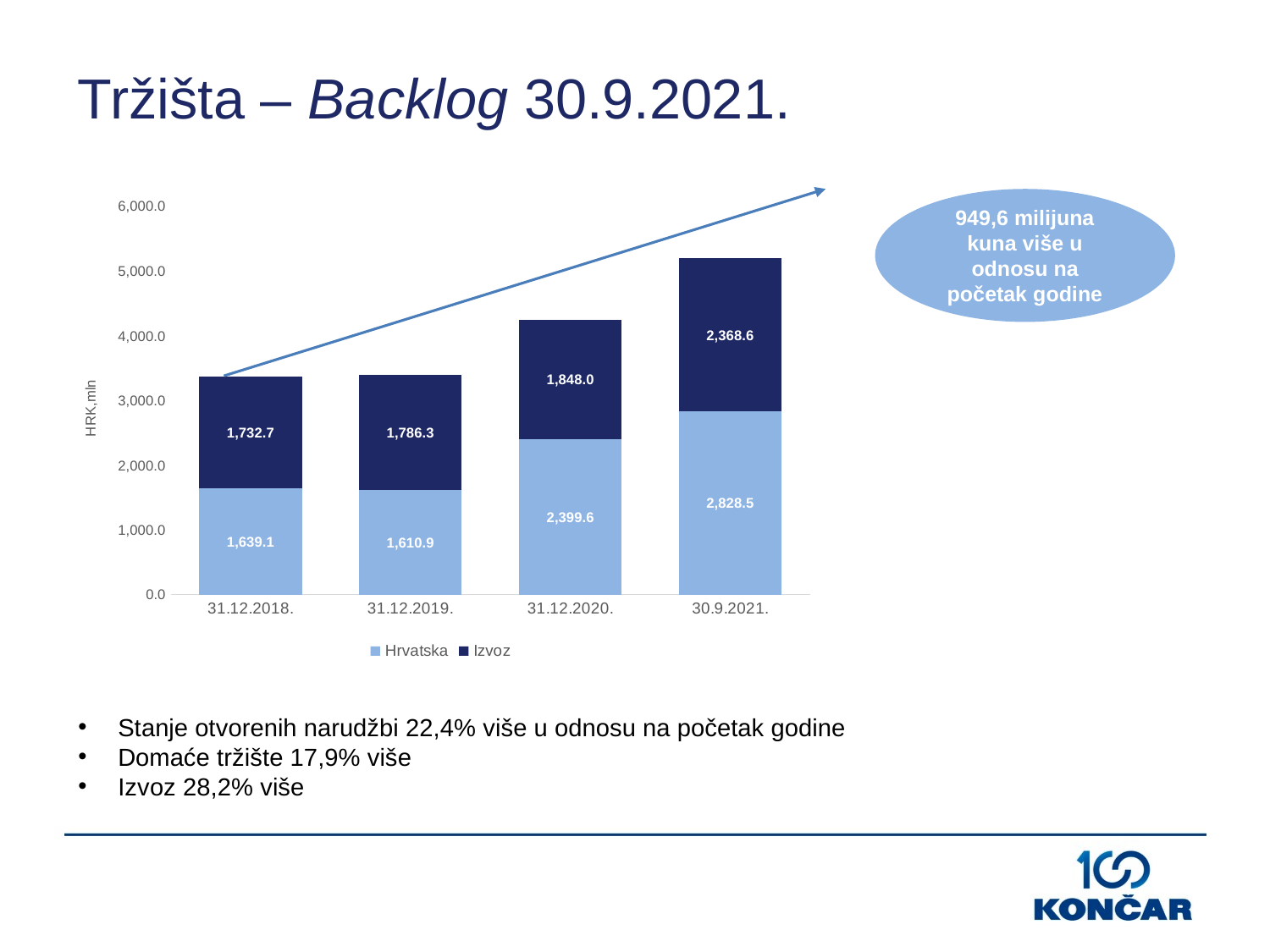
How many series does the legend list? 2 What is the Hrvatska value for 31.12.2018.? 1,639.1 What is the difference between the Izvoz values for 30.9.2021. and 31.12.2020.? 520.6 What is the total of the stacked bar for 31.12.2020.? 4,247.6 What is the total of the stacked bar for 30.9.2021.? 5,197.1 What is the Izvoz value for 31.12.2019.? 1,786.3 What kind of chart is shown on the slide? Stacked bar chart Which date has the lowest Hrvatska value? 31.12.2019. How many dates are shown on the x axis of the chart? 4 What is the Hrvatska value for 30.9.2021.? 2,828.5 Which is larger for 31.12.2020., the Hrvatska value or the Izvoz value? Hrvatska Which date has the highest Izvoz value? 30.9.2021.